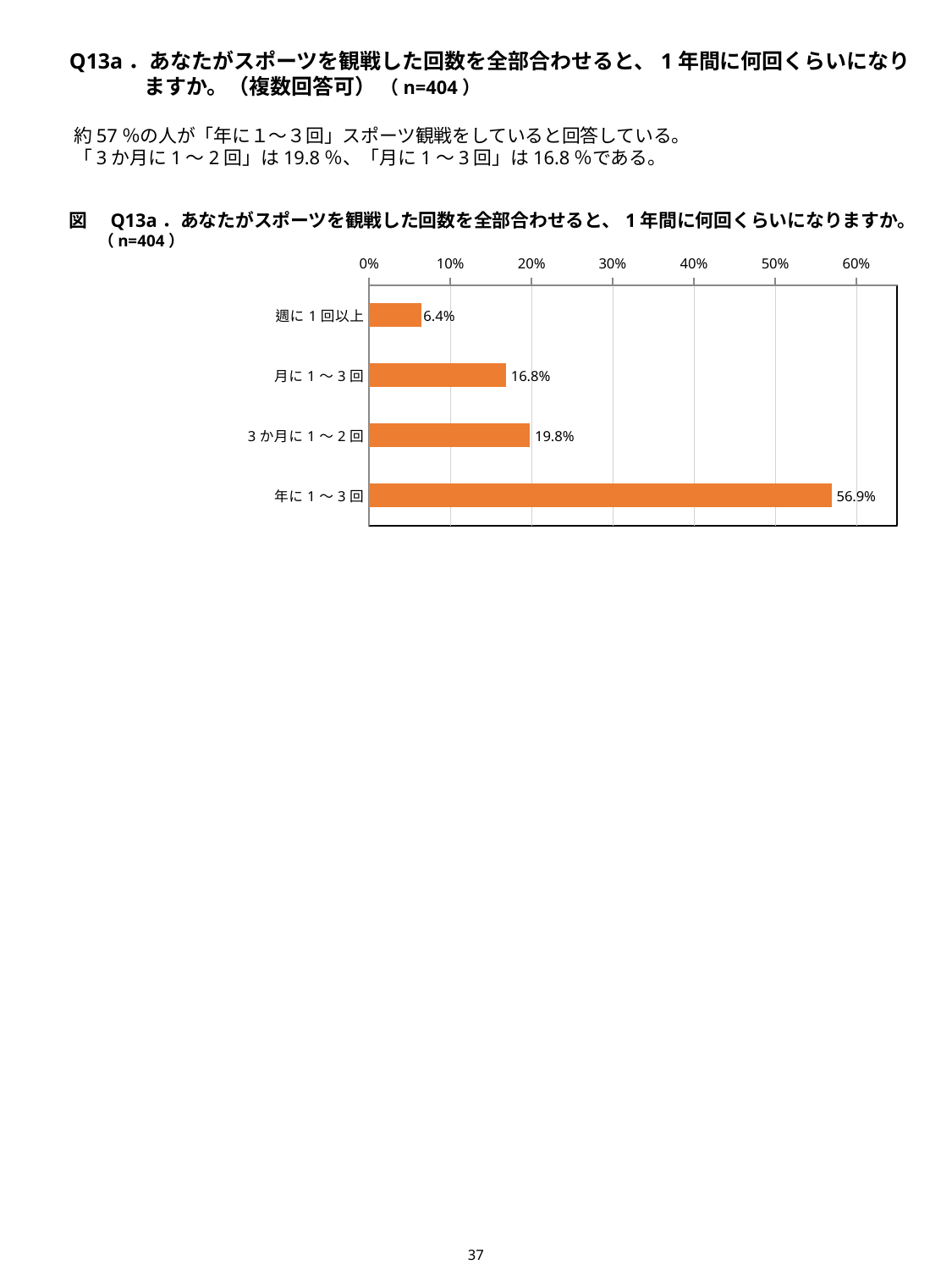
Is the value for 年に１～３回 greater or less than 50%? greater What is the value for 年に１～３回? 56.9% Which category has the lowest value? 週に１回以上 What is the value for 週に１回以上? 6.4% What is the difference between the values for 年に１～３回 and ３か月に１～２回? 37.1% Which category has the highest value? 年に１～３回 Which is larger, the value for 月に１～３回 or the value for 週に１回以上? 月に１～３回 What is the value for 月に１～３回? 16.8% How many categories are shown in the chart? 4 What is the difference between the values for ３か月に１～２回 and 月に１～３回? 3.0% What is the value for ３か月に１～２回? 19.8% What kind of chart is shown on the slide? bar chart